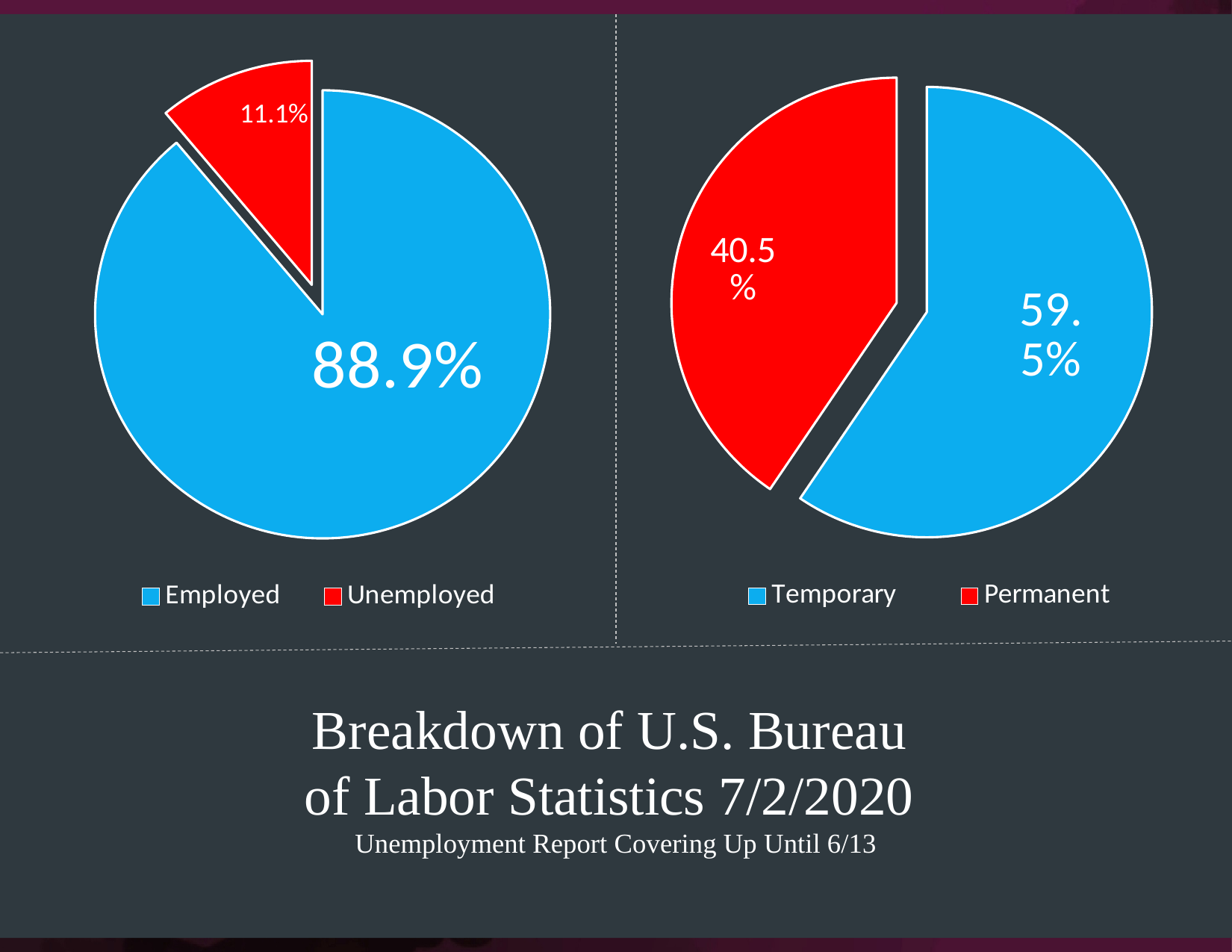
In the right pie chart, what is the difference in percentage points between Temporary and Permanent? 19 In the right pie chart, what share is labelled for Permanent? 40.5% What kind of chart is the left chart? Pie chart How many slices does the right pie chart have? 2 In the left pie chart, which slice is the largest? Employed In the right pie chart, what share is labelled for Temporary? 59.5% How many entries does the legend of the left pie chart list? 2 In the right pie chart, which slice is the smallest? Permanent In the left pie chart, what share is labelled for Unemployed? 11.1% In the left pie chart, what is the difference in percentage points between Employed and Unemployed? 77.8 In the left pie chart, what share is labelled for Employed? 88.9% In the right pie chart, which is larger, Temporary or Permanent? Temporary